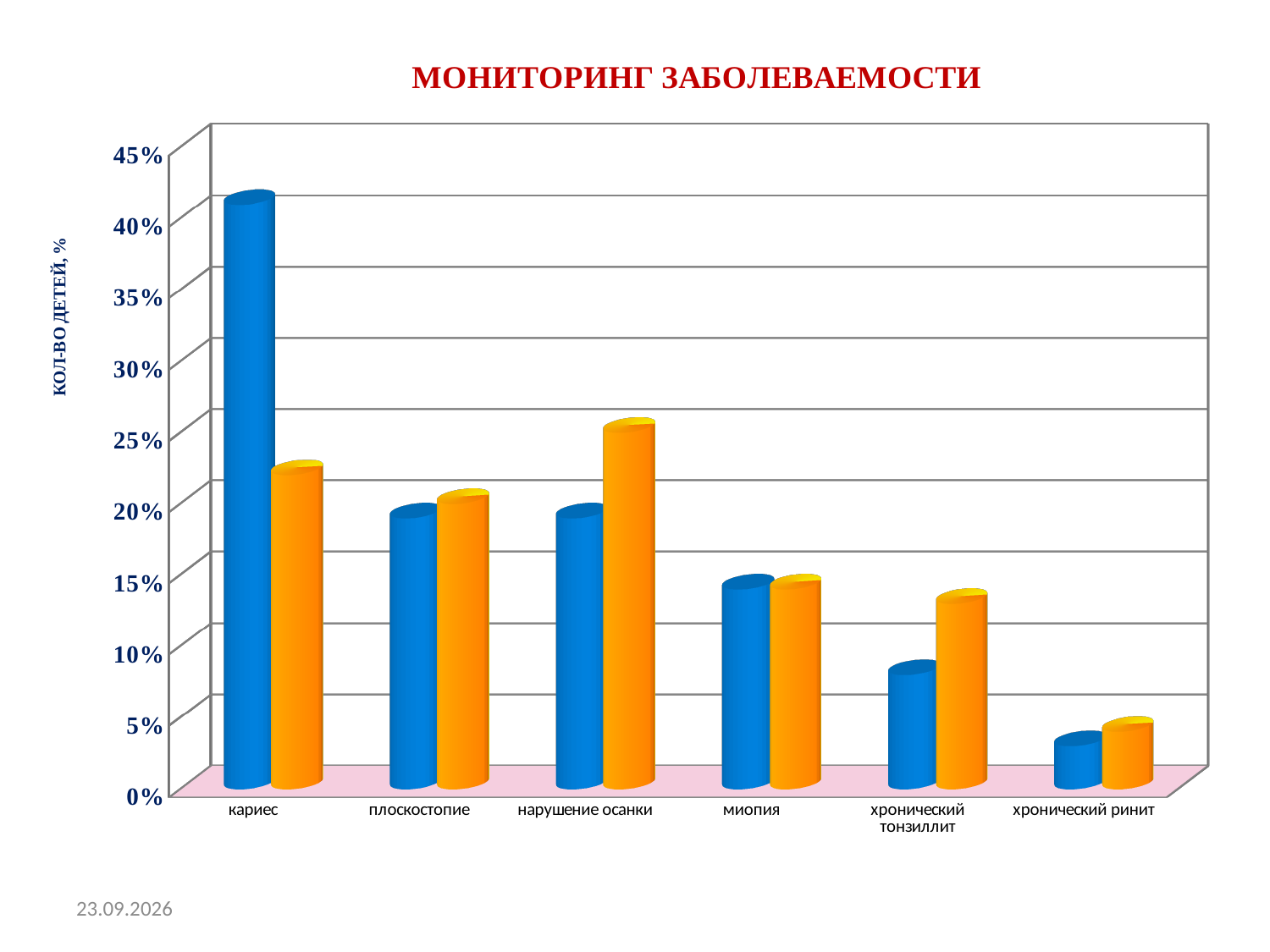
What is the title of the chart? МОНИТОРИНГ ЗАБОЛЕВАЕМОСТИ Which category has the highest blue bar? кариес Which category has the lowest orange bar? хронический ринит For нарушение осанки, which bar is taller, the blue one or the orange one? orange What is the label of the vertical axis? КОЛ-ВО ДЕТЕЙ, % Is the blue bar for кариес greater or less than 40%? greater For кариес, which bar is taller, the blue one or the orange one? blue Which category has the highest orange bar? нарушение осанки Is the orange bar for хронический тонзиллит greater or less than 10%? greater What kind of chart is shown on the slide? bar chart How many categories are shown on the x axis of the chart? 6 Which category has the lowest blue bar? хронический ринит